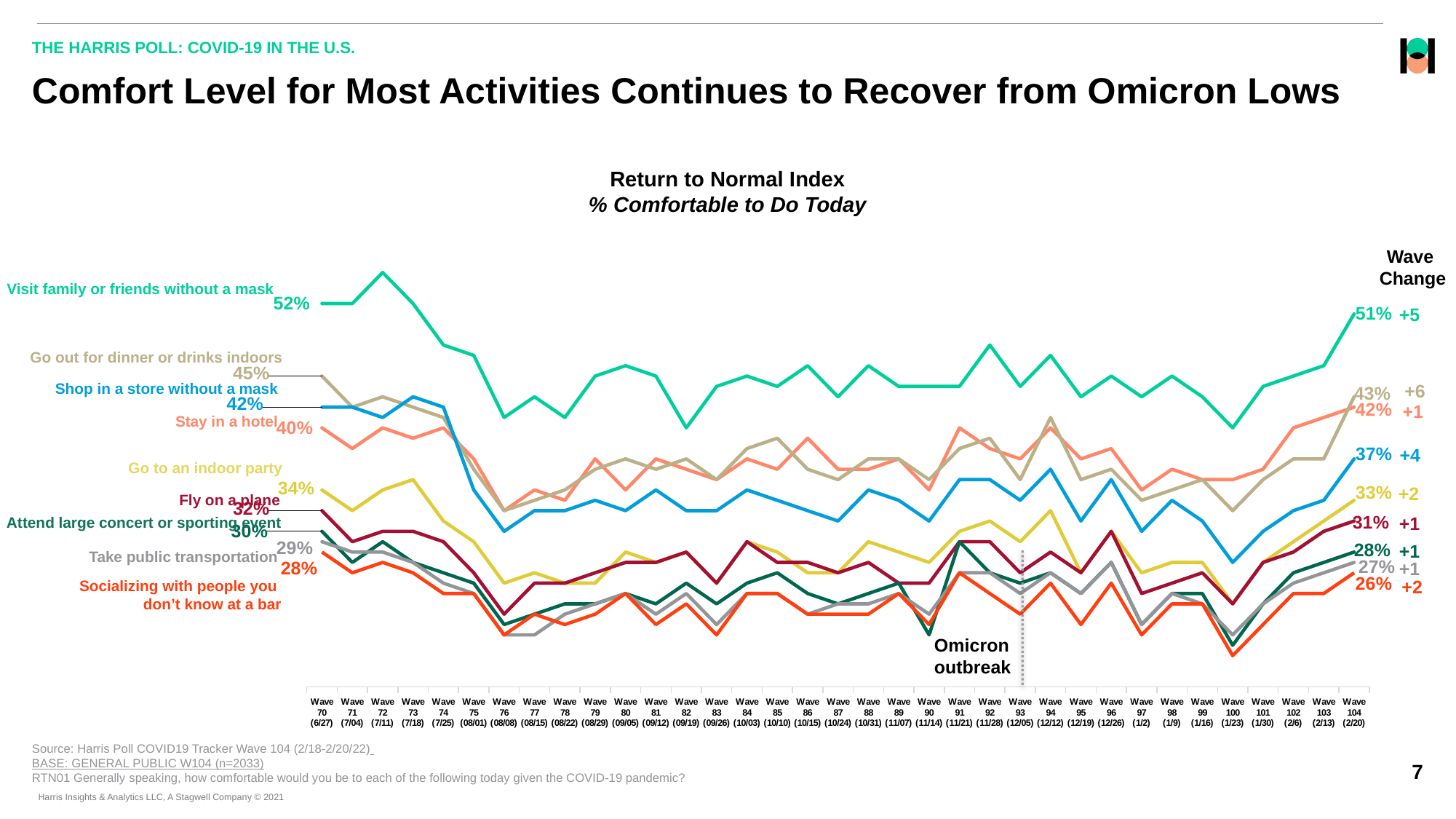
What is the value for "Stay in a hotel" at Wave 70? 40% What is the value for "Socializing with people you don't know at a bar" at Wave 104? 26% At Wave 104, which is larger: "Stay in a hotel" or "Go to an indoor party"? Stay in a hotel Which activity has the highest value at Wave 104? Visit family or friends without a mask Which activity has the lowest value at Wave 70? Socializing with people you don't know at a bar Did the value for "Shop in a store without a mask" rise or fall from Wave 70 to Wave 104? Fall How many activity series are plotted on the chart? 9 How many waves are plotted on the x axis? 35 What is the value for "Visit family or friends without a mask" at Wave 104? 51% What is the wave change shown for "Go out for dinner or drinks indoors"? +6 What kind of chart is shown on the slide? Line chart What is the difference between the Wave 104 values for "Go out for dinner or drinks indoors" and "Shop in a store without a mask"? 6 percentage points